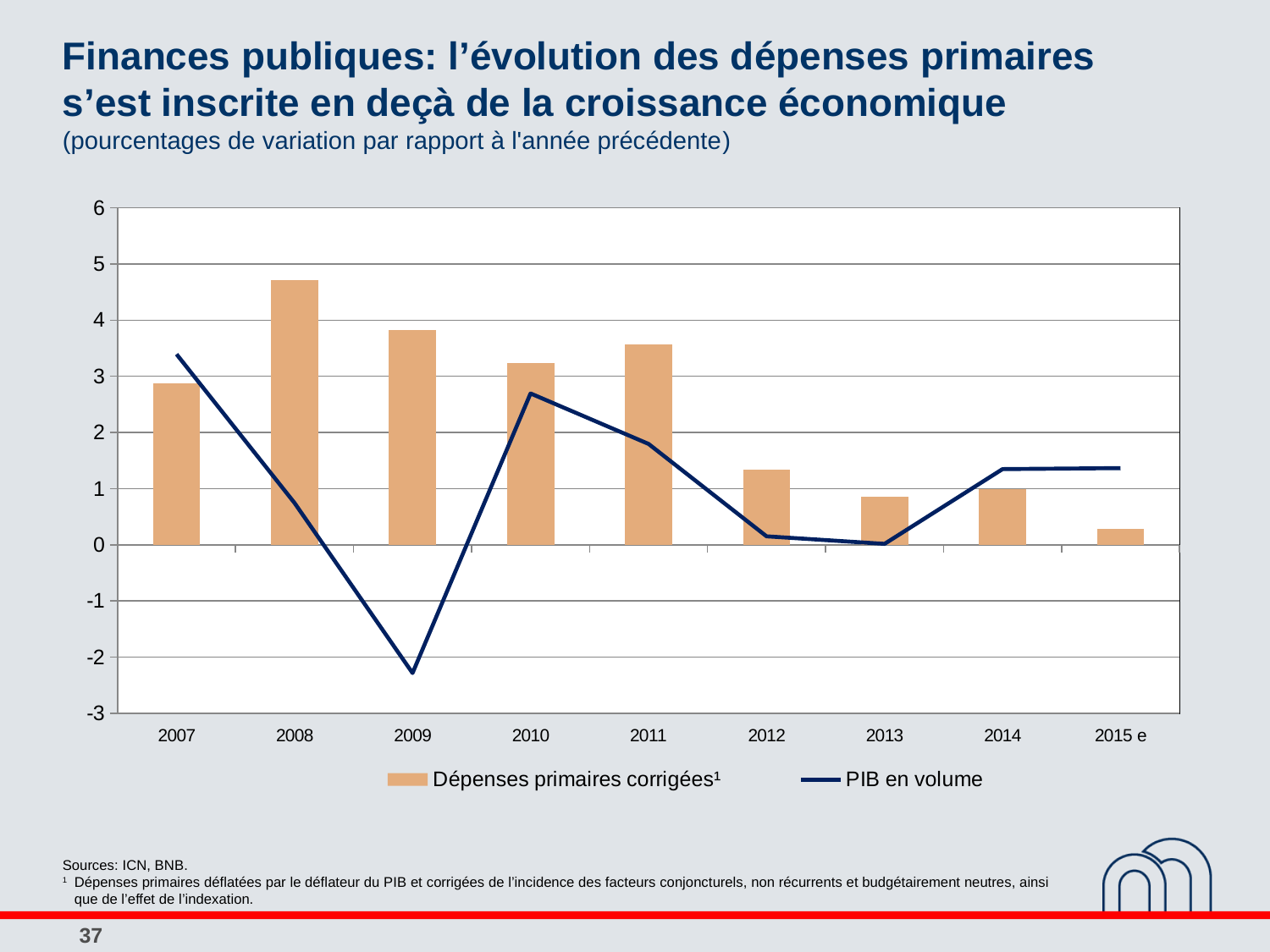
Which year has the lowest value for Dépenses primaires corrigées? 2015 e Is the value for Dépenses primaires corrigées in 2015 e greater or less than 1? less In which year does PIB en volume reach its lowest value? 2009 What kind of chart is shown on the slide? Combined bar and line chart Is the value for PIB en volume in 2009 greater or less than -2? less In 2009, which is larger: Dépenses primaires corrigées or PIB en volume? Dépenses primaires corrigées In 2007, which is larger: Dépenses primaires corrigées or PIB en volume? PIB en volume Is the value for Dépenses primaires corrigées in 2008 greater or less than 4? greater How many years are shown on the x axis? 9 Which year has the highest value for Dépenses primaires corrigées? 2008 How many series does the legend list? 2